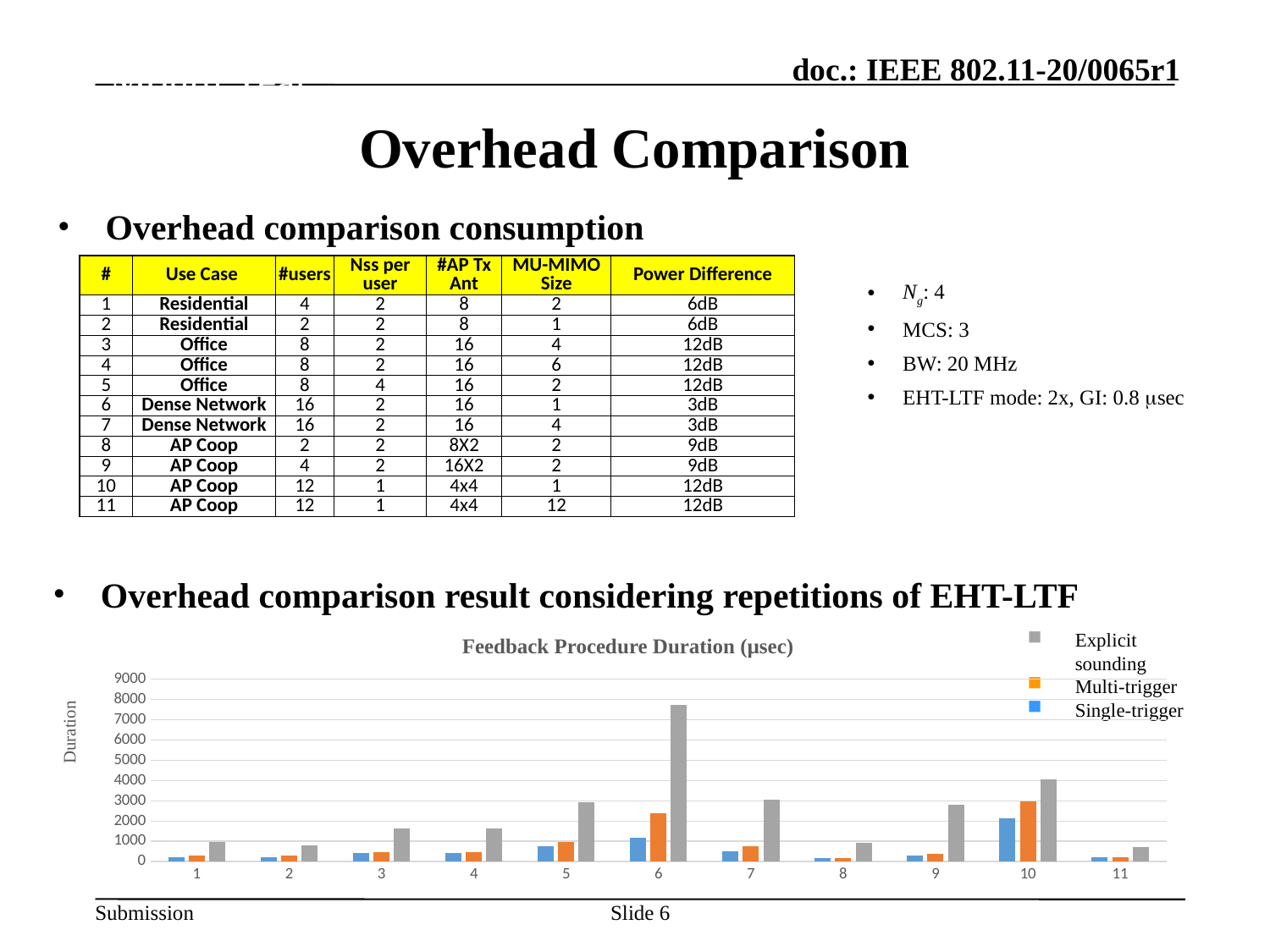
How many series does the legend of the "Feedback Procedure Duration (μsec)" chart list? 3 In the "Feedback Procedure Duration (μsec)" chart, is the Multi-trigger value for category 6 greater or less than 2000? greater In the "Feedback Procedure Duration (μsec)" chart, which category has the highest Explicit sounding value? 6 In the "Feedback Procedure Duration (μsec)" chart, is the Explicit sounding value for category 6 greater or less than 7000? greater In the "Feedback Procedure Duration (μsec)" chart, is the Explicit sounding value for category 3 greater or less than 1000? greater In the "Feedback Procedure Duration (μsec)" chart, which category has the highest Single-trigger value? 10 In the "Feedback Procedure Duration (μsec)" chart, which category has the highest Multi-trigger value? 10 What kind of chart is the "Feedback Procedure Duration (μsec)" chart? bar chart Which series in the "Feedback Procedure Duration (μsec)" chart is drawn in gray? Explicit sounding How many categories are shown on the x axis of the "Feedback Procedure Duration (μsec)" chart? 11 In the "Feedback Procedure Duration (μsec)" chart, which is larger: the Explicit sounding value for category 6 or for category 10? category 6